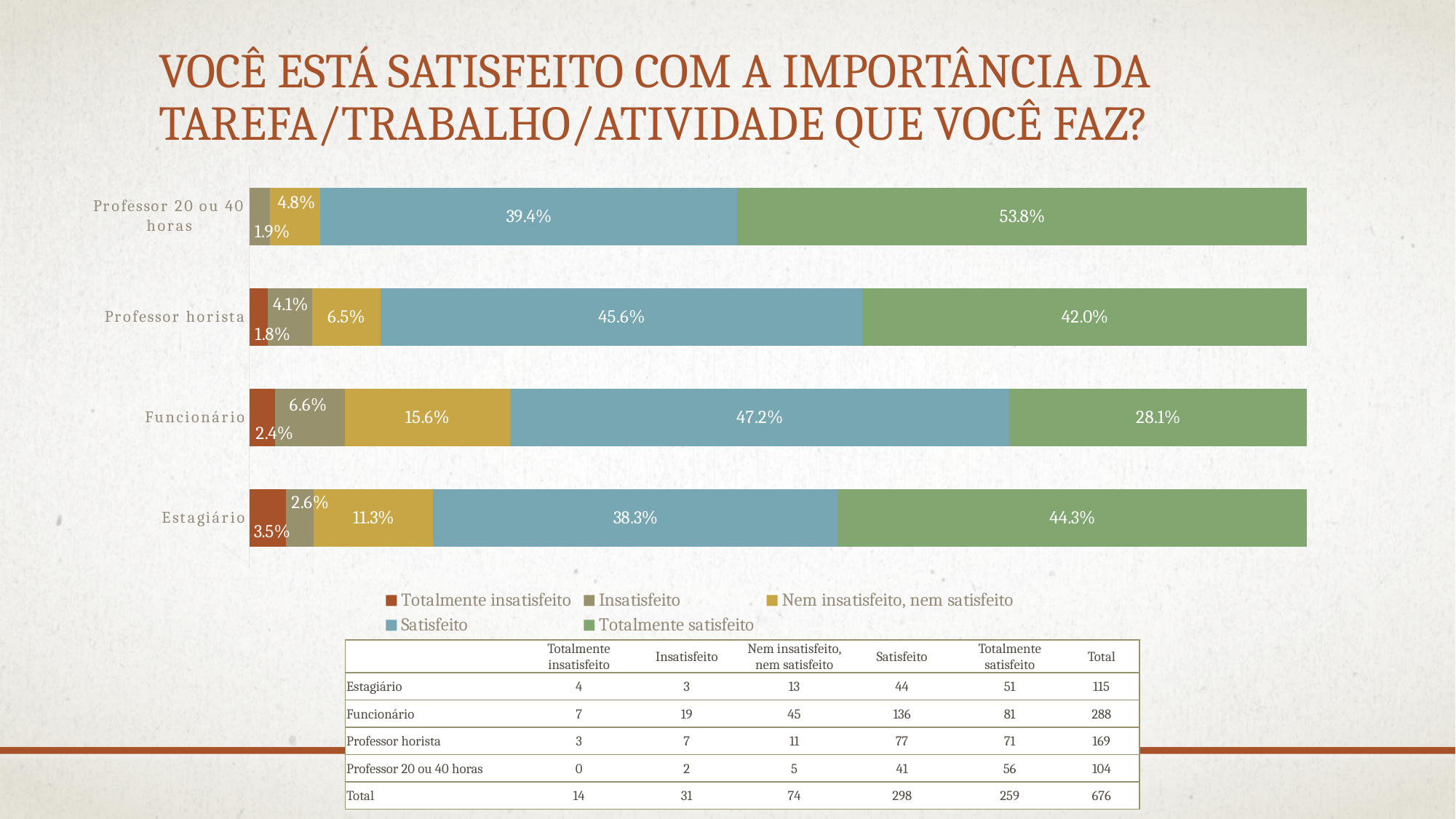
What is the value for Satisfeito in the Professor horista bar? 45.6% What is the value for Totalmente insatisfeito in the Estagiário bar? 3.5% How many series does the legend list? 5 What kind of chart is shown on the slide? Stacked bar chart What is the difference between the Satisfeito values for Funcionário and Estagiário? 8.9 percentage points What is the value for Totalmente satisfeito in the Funcionário bar? 28.1% Which is larger, the Nem insatisfeito, nem satisfeito value for Funcionário or for Estagiário? Funcionário How many categories are shown on the chart? 4 Which category has the lowest Totalmente satisfeito value? Funcionário What colour represents Satisfeito in the legend? Blue Which category has the highest Nem insatisfeito, nem satisfeito value? Funcionário Which category has the highest Totalmente satisfeito value? Professor 20 ou 40 horas